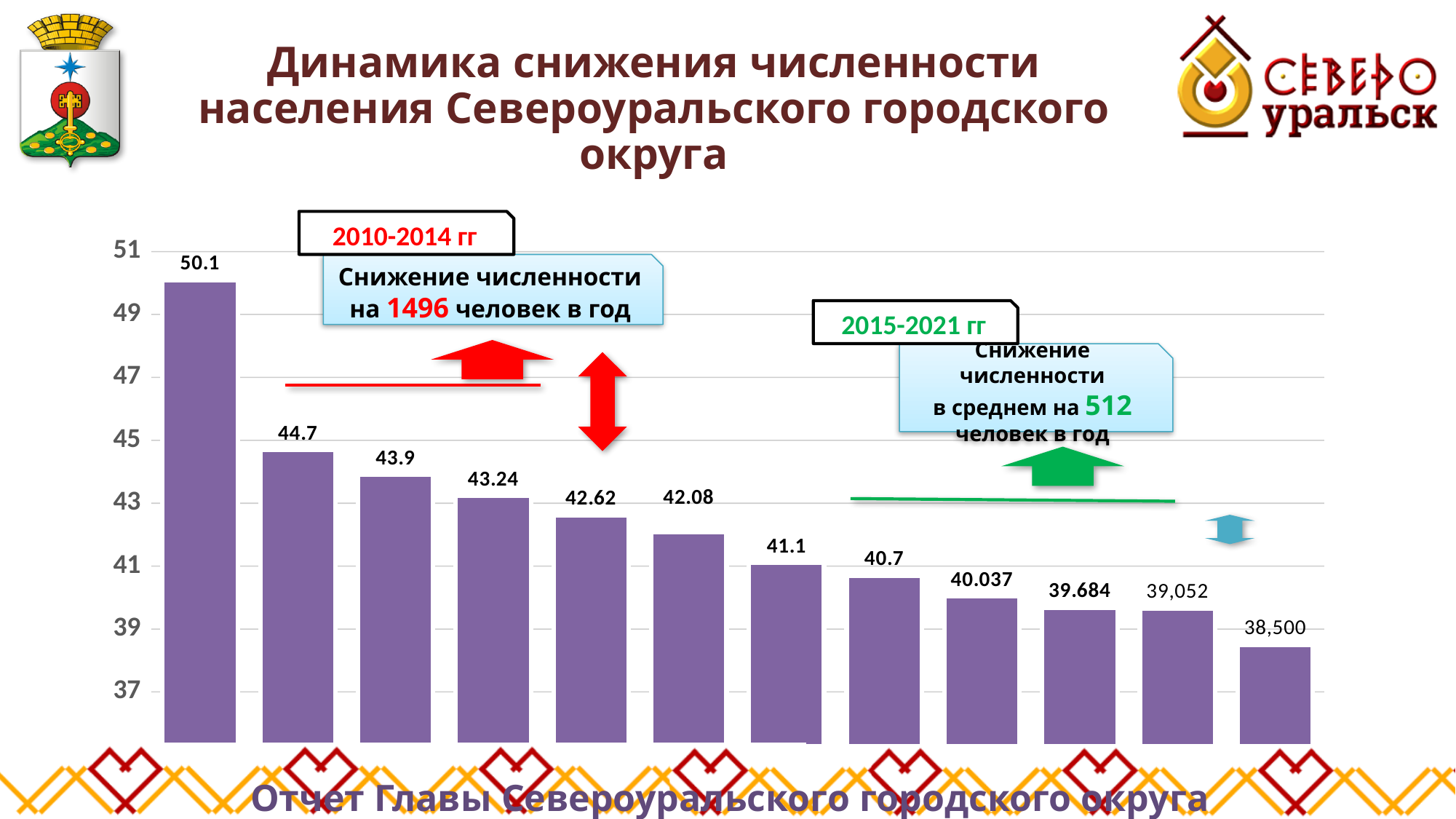
What is the value shown on the first (leftmost) bar? 50.1 How many bars are plotted in the chart? 12 What is the value shown on the last (rightmost) bar? 38,500 Which is larger, the value of the seventh bar or the value of the eighth bar? the seventh bar (41.1) According to the annotation for 2010-2014, by how many people per year did the population decrease? 1496 What is the value shown on the fourth bar from the left? 43.24 Which bar has the highest value? the first (leftmost) bar, 50.1 What is the difference between the first bar (50.1) and the second bar (44.7)? 5.4 What kind of chart is shown on the slide? bar chart Do the bar values rise or fall from left to right across the chart? fall Which bar has the lowest value? the last (rightmost) bar, 38,500 What is the value shown on the ninth bar from the left? 40.037